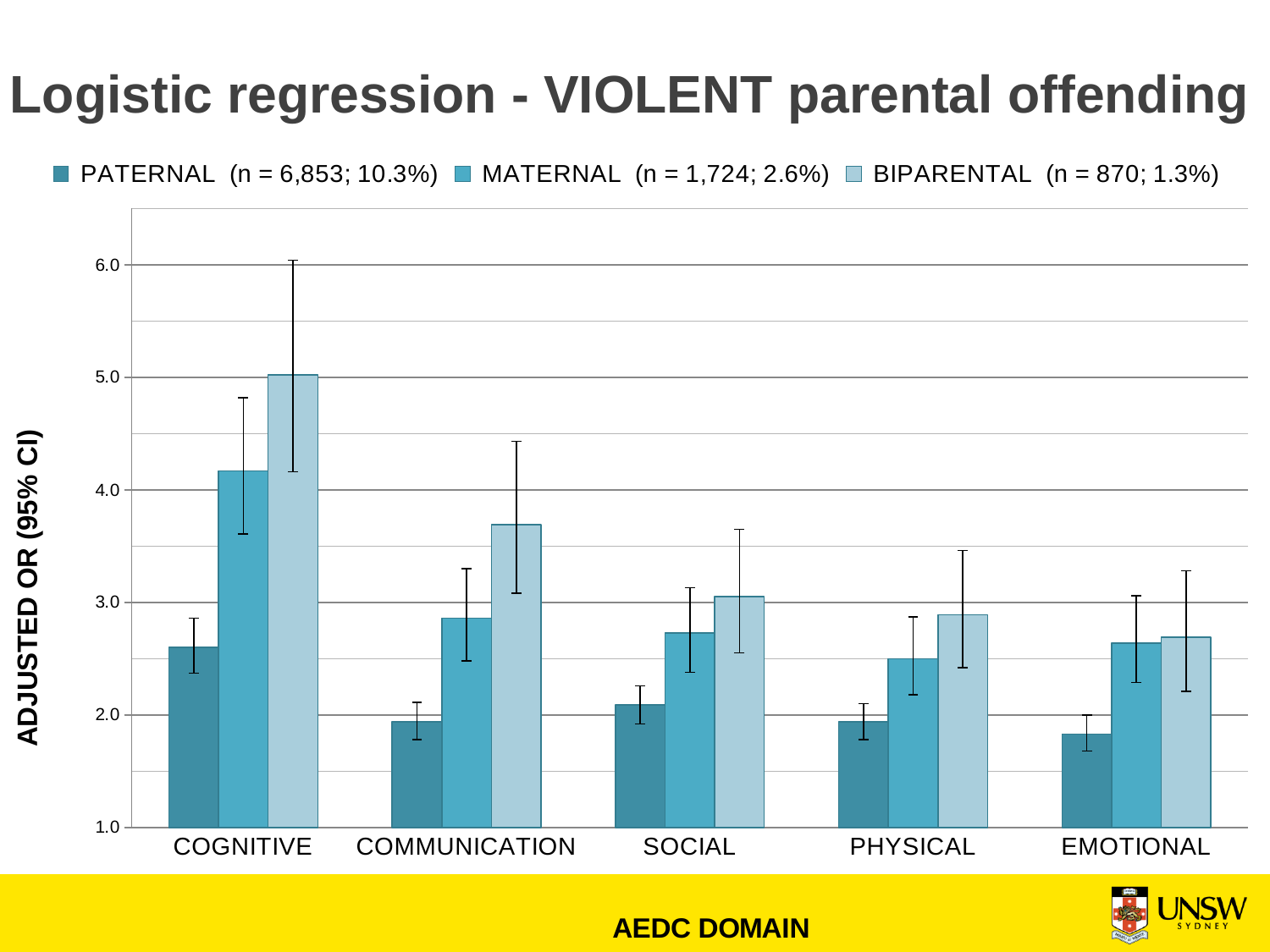
How many series does the legend list? 3 What kind of chart is shown on the slide? Bar chart Which domain has the lowest MATERNAL bar? PHYSICAL Is the MATERNAL value for SOCIAL greater or less than 3.0? less Do the BIPARENTAL bars rise or fall moving from COGNITIVE to EMOTIONAL along the x axis? fall How many AEDC domains are shown on the x axis? 5 Which domain has the highest BIPARENTAL bar? COGNITIVE Which domain has the highest PATERNAL bar? COGNITIVE For the COGNITIVE domain, which is larger: the MATERNAL bar or the BIPARENTAL bar? BIPARENTAL Is the BIPARENTAL value for COGNITIVE greater or less than 4.0? greater Is the BIPARENTAL value for COMMUNICATION greater or less than 3.0? greater What is the y-axis title of the chart? ADJUSTED OR (95% CI)